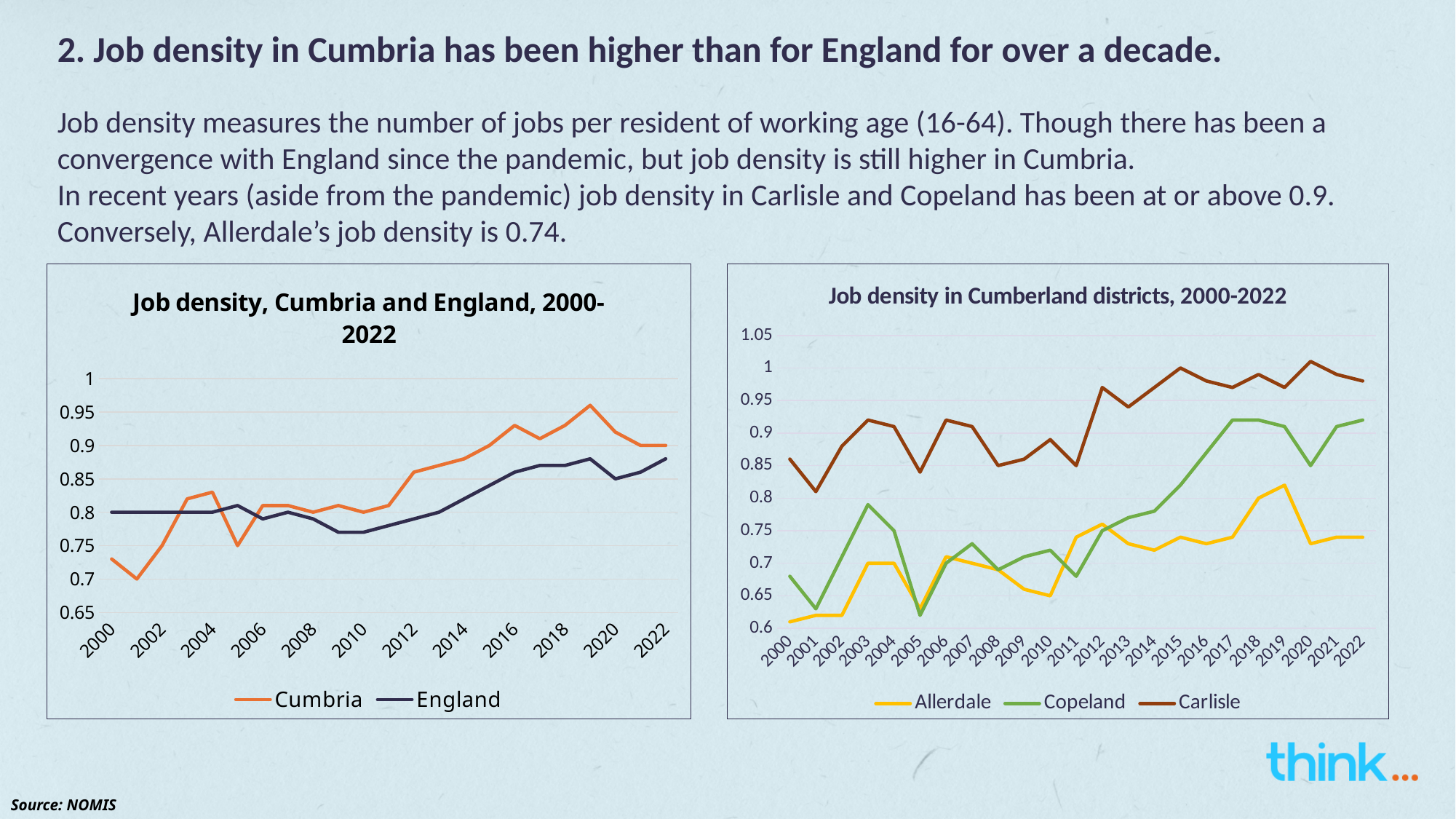
In the 'Job density in Cumberland districts, 2000-2022' chart, what is the job density for Carlisle in 2015? 1 In the 'Job density, Cumbria and England, 2000-2022' chart, is the value for Cumbria in 2019 greater or less than 0.9? greater How many series does the legend of the 'Job density, Cumbria and England, 2000-2022' chart list? 2 In the 'Job density in Cumberland districts, 2000-2022' chart, which district has the highest job density in 2022? Carlisle What kind of chart is the 'Job density, Cumbria and England, 2000-2022' chart? Line chart In the 'Job density, Cumbria and England, 2000-2022' chart, which series has the higher value in 2019, Cumbria or England? Cumbria How many series does the legend of the 'Job density in Cumberland districts, 2000-2022' chart list? 3 In the 'Job density, Cumbria and England, 2000-2022' chart, what is the job density for England in 2000? 0.8 In the 'Job density in Cumberland districts, 2000-2022' chart, which districts are listed in the legend? Allerdale, Copeland, Carlisle In the 'Job density, Cumbria and England, 2000-2022' chart, does the England line rise or fall between 2010 and 2019? Rise In the 'Job density in Cumberland districts, 2000-2022' chart, which district has the lowest job density in 2022? Allerdale In the 'Job density in Cumberland districts, 2000-2022' chart, is the value for Copeland in 2005 greater or less than 0.65? less